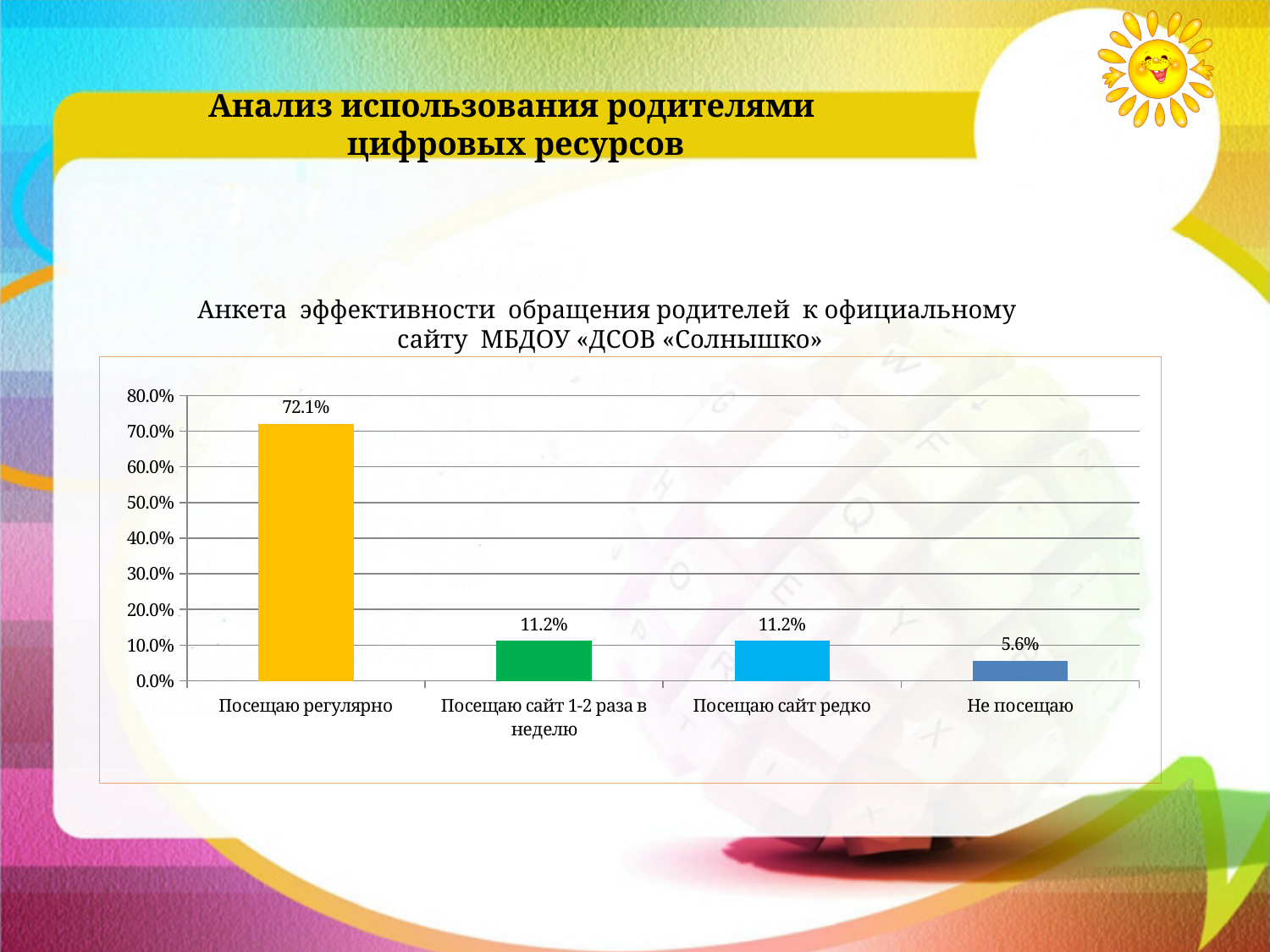
What is the value for "Посещаю регулярно"? 72.1% What kind of chart is shown on the slide? bar chart What is the difference between the values for "Посещаю сайт редко" and "Не посещаю"? 5.6% What is the value for "Не посещаю"? 5.6% Which is larger: the value for "Посещаю сайт 1-2 раза в неделю" or the value for "Не посещаю"? Посещаю сайт 1-2 раза в неделю Which category has the lowest value? Не посещаю How many categories are shown on the x axis? 4 Which category has the highest value? Посещаю регулярно What is the difference between the values for "Посещаю регулярно" and "Не посещаю"? 66.5% What colour is the bar for "Посещаю регулярно"? yellow Is the value for "Посещаю регулярно" greater or less than 70.0%? greater What is the value for "Посещаю сайт редко"? 11.2%